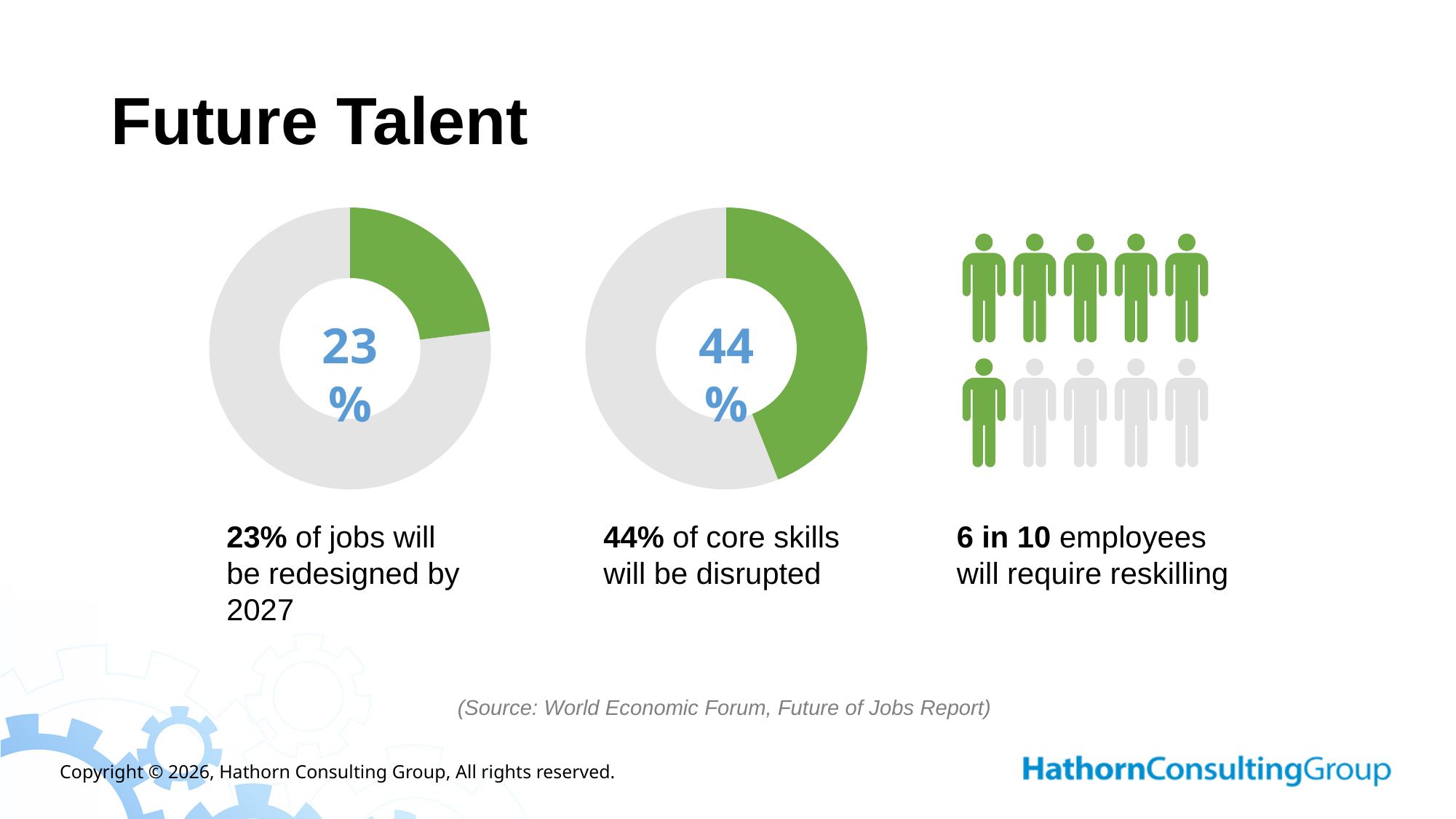
In the middle donut chart, is the green share greater or less than 50%? less What value is printed in the centre of the middle donut chart? 44% According to the right pictogram, how many employees in 10 will require reskilling? 6 in 10 Which donut chart shows the larger green share, the left one (jobs redesigned) or the middle one (core skills disrupted)? the middle one (44%) What value is printed in the centre of the left donut chart? 23% In the left donut chart, what share of the ring is grey (not green)? 77% How many donut charts are on the slide? 2 What kind of chart is the left chart showing 23%? donut chart How many person icons are shown in the pictogram on the right? 10 What colour is used for the highlighted portion in the donut charts and pictogram? green How many of the person icons in the right pictogram are green? 6 What is the difference between the value in the middle donut chart (44%) and the value in the left donut chart (23%)? 21 percentage points